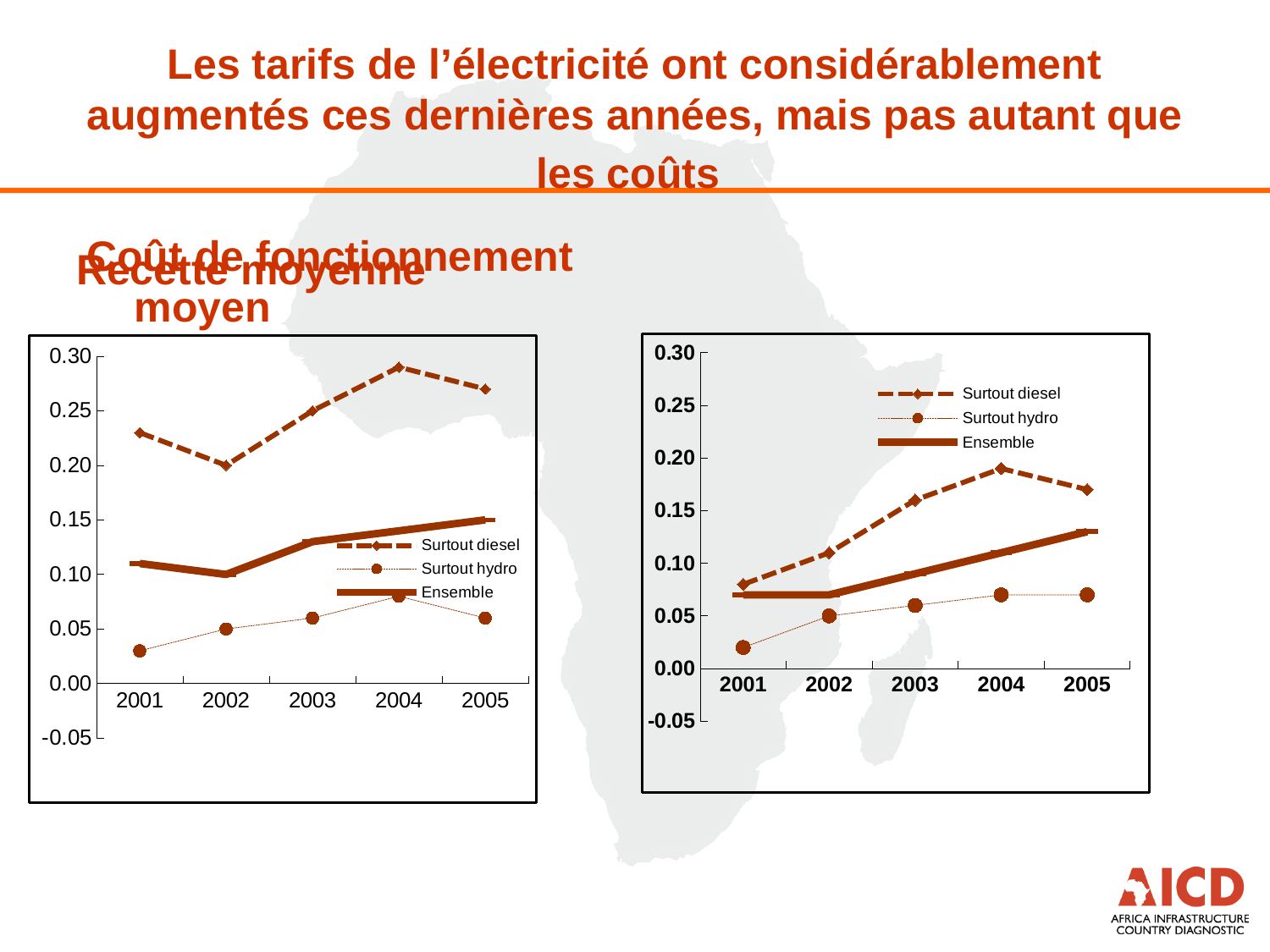
What are the three legend entries of the chart on the left? Surtout diesel, Surtout hydro, Ensemble What kind of chart is the chart on the left of the slide? line chart In the chart on the right, is the value for Surtout diesel in 2004 greater or less than 0.15? greater In the chart on the right, does the Ensemble line rise or fall from 2002 to 2005? rises In the chart on the right, which series has the lowest value in 2005? Surtout hydro In the chart on the left, is the value for Surtout diesel in 2004 greater or less than 0.25? greater In the chart on the left, is the value for Surtout hydro in 2001 greater or less than 0.05? less In the chart on the left, in which year is Surtout diesel at its lowest? 2002 In the chart on the left, in which year is Surtout diesel at its highest? 2004 In the chart on the right, which is larger in 2005: Surtout diesel or Ensemble? Surtout diesel How many series does the legend of the chart on the right list? 3 How many years are shown on the x axis of the chart on the left? 5